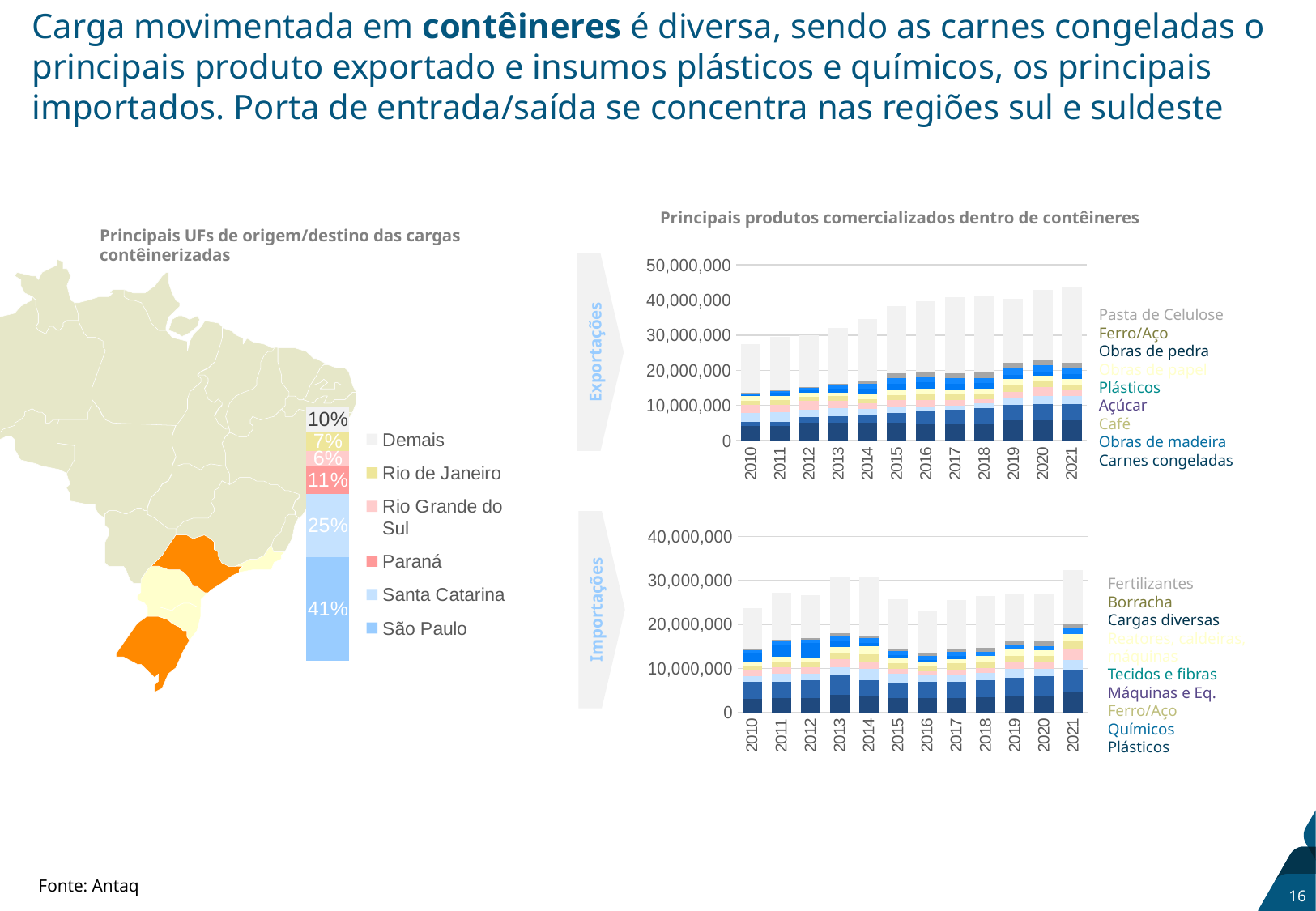
In the Importações chart, is the total for 2016 greater or less than 30,000,000? less In the Exportações chart, how many product series does the legend list? 9 In the Importações chart, which year has the highest total? 2021 In the chart 'Principais UFs de origem/destino das cargas contêinerizadas', what is the share for Santa Catarina? 25% In the chart 'Principais UFs de origem/destino das cargas contêinerizadas', what is the share for Paraná? 11% In the Exportações chart, is the total for 2021 greater or less than 40,000,000? greater In the Exportações chart, how many years are shown on the x axis? 12 In the chart 'Principais UFs de origem/destino das cargas contêinerizadas', what is the difference between the shares of São Paulo and Santa Catarina? 16% In the chart 'Principais UFs de origem/destino das cargas contêinerizadas', how many entries does the legend list? 6 In the chart 'Principais UFs de origem/destino das cargas contêinerizadas', which UF has the largest share? São Paulo In the Exportações chart, do the total values generally rise or fall from 2010 to 2021? rise In the chart 'Principais UFs de origem/destino das cargas contêinerizadas', what is the share for São Paulo? 41%